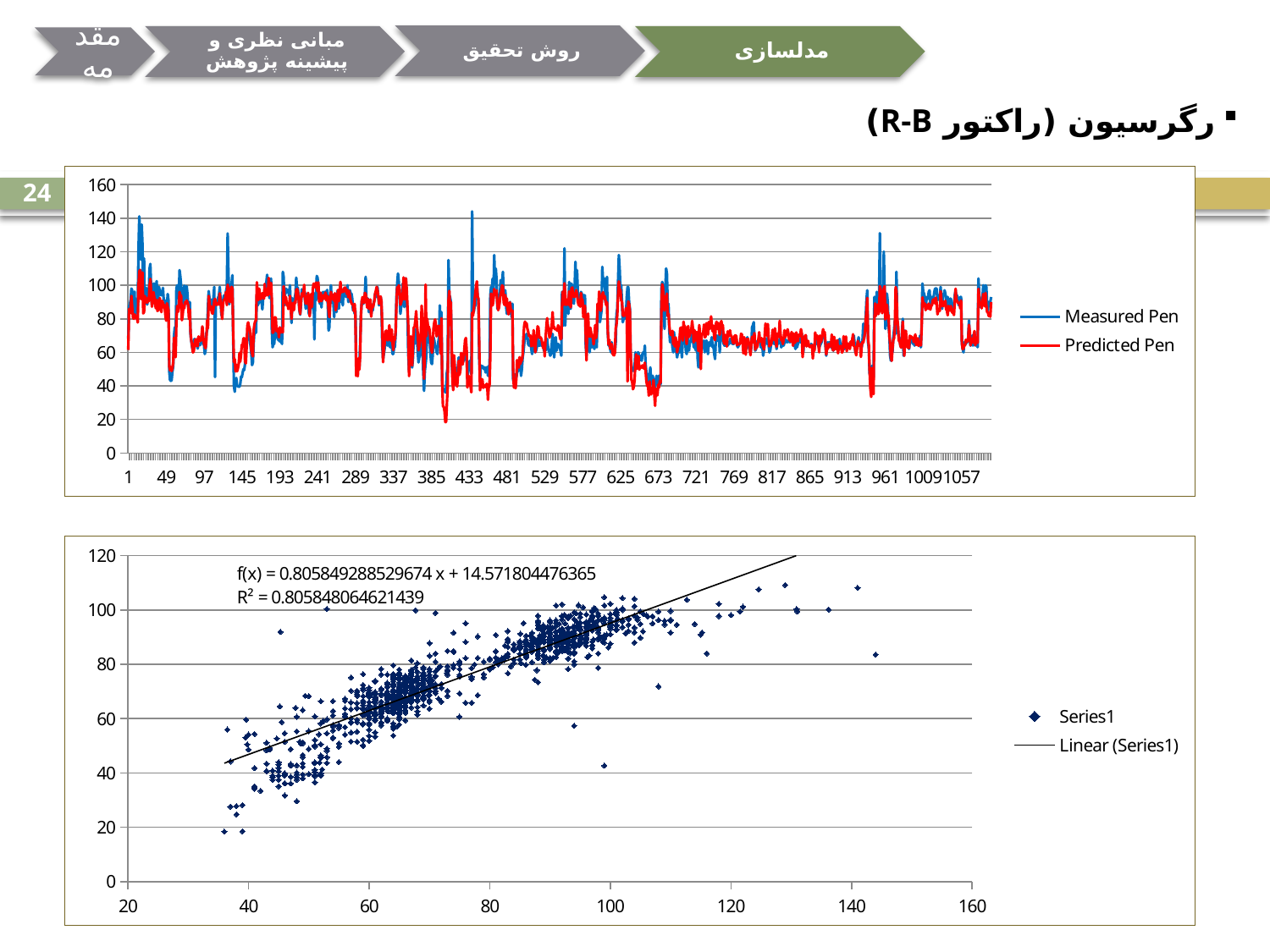
What is the intercept of the linear fit equation printed on the bottom chart? 14.571804476365 What kind of chart is the top chart on the slide? Line chart What kind of chart is the bottom chart on the slide? Scatter chart In the top chart, is the lowest value of the Predicted Pen series greater or less than 40? less What is the R² value printed on the bottom chart? 0.805848064621439 What is the highest value shown on the vertical axis of the top chart? 160 How many series does the legend of the top chart list? 2 In the bottom chart, do the Series1 points generally rise or fall as the x value increases? rise How many series does the legend of the bottom chart list? 2 In the top chart, is the highest value of the Measured Pen series greater or less than 120? greater What is the slope of the linear fit equation printed on the bottom chart? 0.805849288529674 In the top chart, which series is drawn in red? Predicted Pen